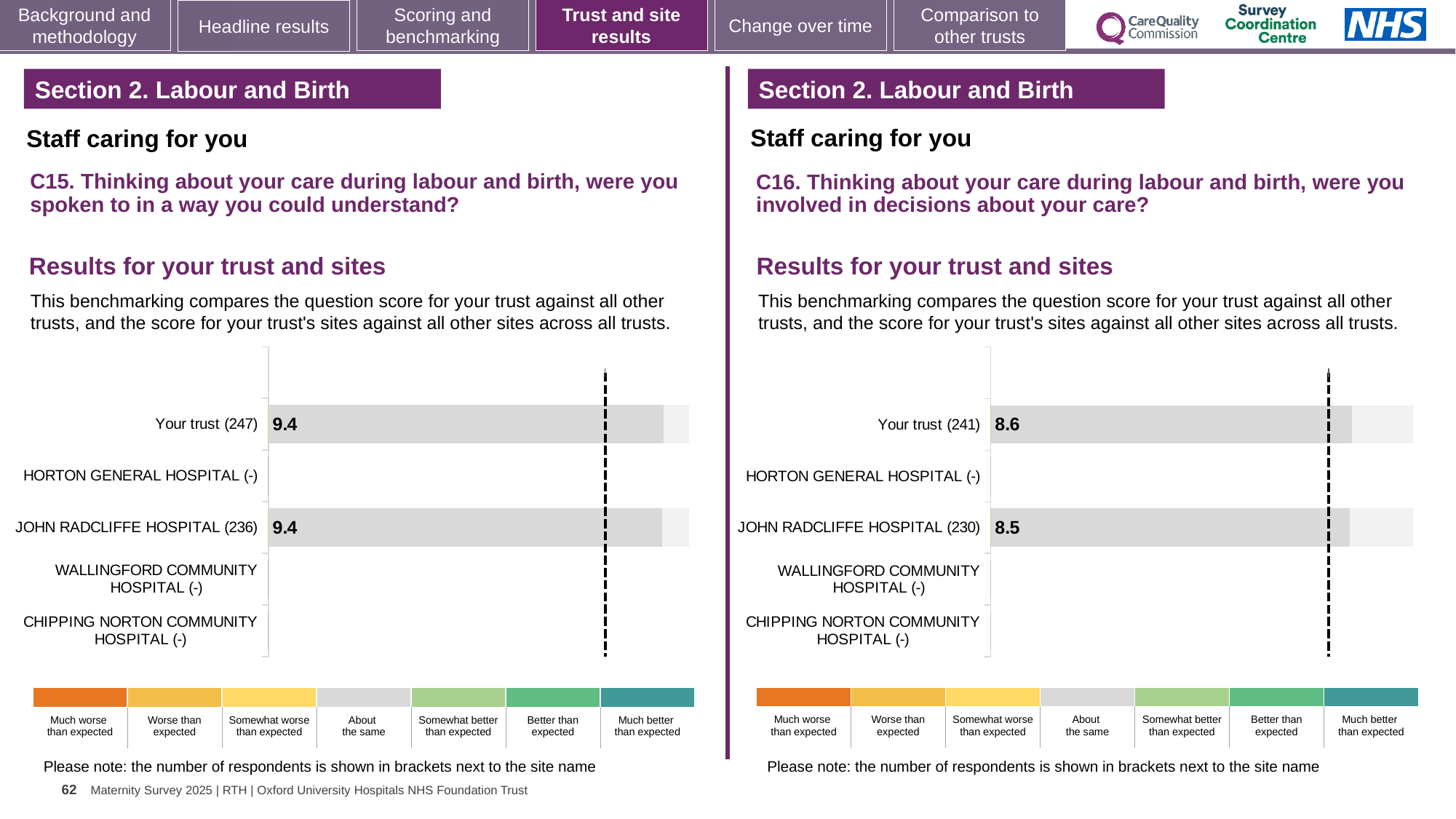
In the C16 chart on the right, which has the higher score, Your trust or JOHN RADCLIFFE HOSPITAL? Your trust In the C16 chart on the right, what is the difference between the score for Your trust and the score for JOHN RADCLIFFE HOSPITAL? 0.1 In the C16 chart on the right, how many respondents are shown in brackets for JOHN RADCLIFFE HOSPITAL? 230 How many categories does the colour key below the C16 chart on the right list? 7 In the C15 chart on the left, how many categories have a plotted bar with a score shown? 2 In the C15 chart on the left, what is the score for Your trust? 9.4 In the C16 chart on the right, what is the score for Your trust? 8.6 What kind of chart is used in the C16 chart on the right? Bar chart In the C16 chart on the right, what is the score for JOHN RADCLIFFE HOSPITAL? 8.5 In the C15 chart on the left, what is the score for JOHN RADCLIFFE HOSPITAL? 9.4 How many site/trust categories are listed on the y axis of the C15 chart on the left? 5 In the C15 chart on the left, how many respondents are shown in brackets for Your trust? 247